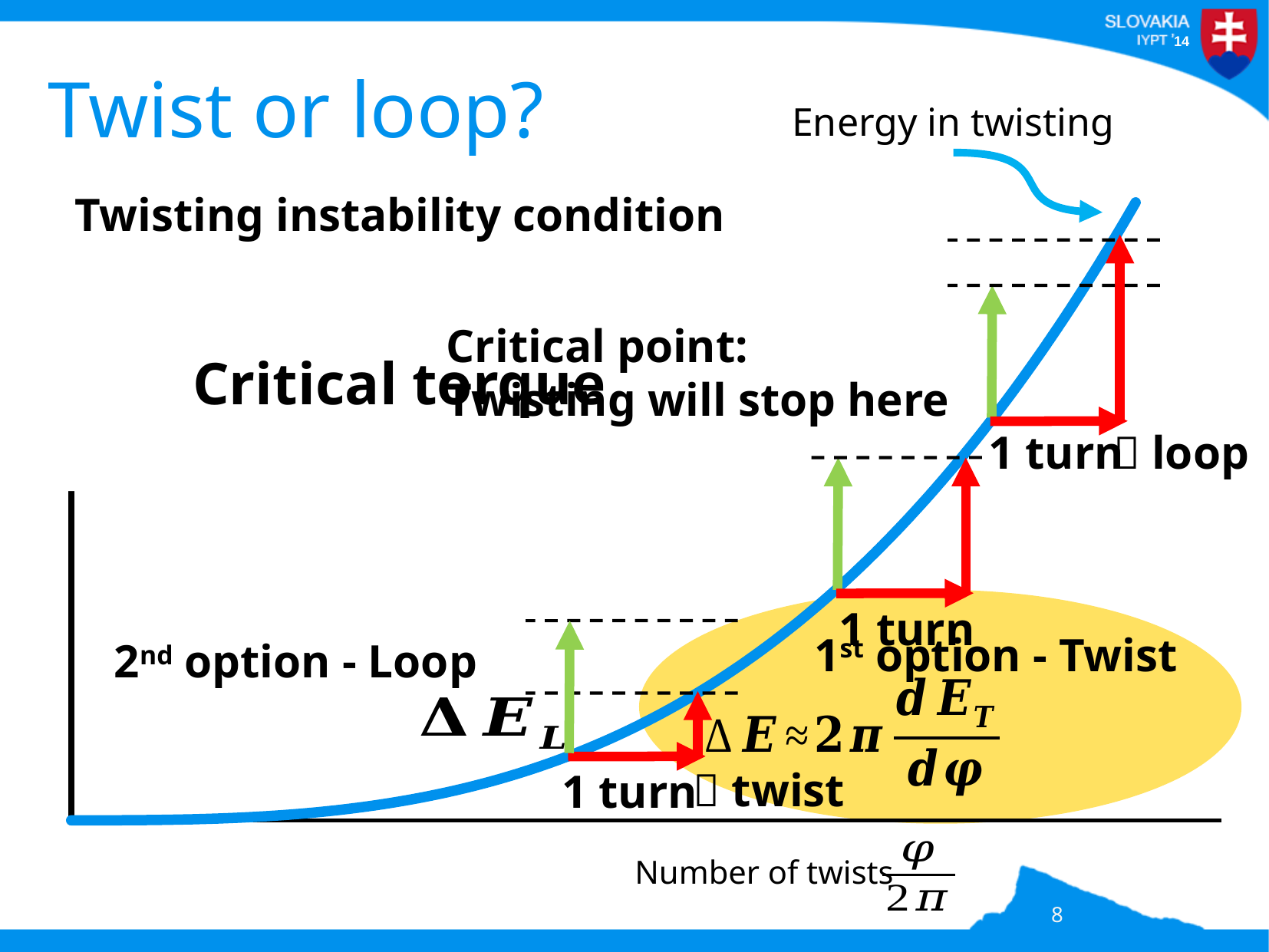
Does the energy in twisting curve rise or fall as the number of twists increases? rise What does the blue curve on the chart represent? Energy in twisting What kind of chart is shown on the slide? line chart What quantity is plotted on the x axis of the chart? Number of twists